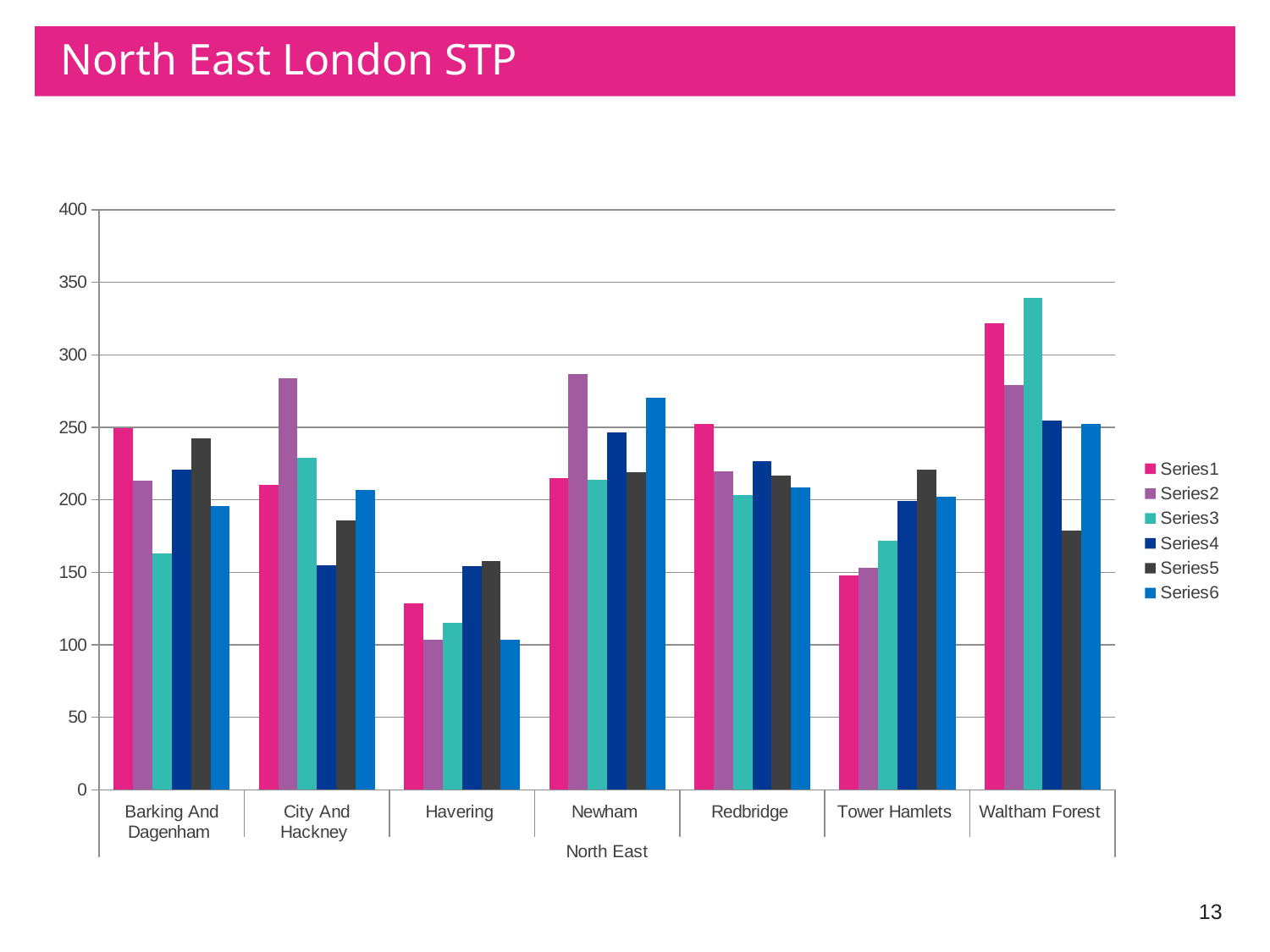
Which borough has the highest value for Series3? Waltham Forest How many boroughs (categories) are shown on the x axis? 7 What label appears beneath the borough names on the x axis? North East What kind of chart is shown on the slide? bar chart Is the Series5 value for Tower Hamlets greater or less than 200? greater Is the Series2 value for City And Hackney greater or less than 250? greater Is the Series3 value for Havering greater or less than 150? less Which is larger: the Series6 value for Newham or the Series6 value for Redbridge? Newham Which is larger: the Series1 value for Waltham Forest or the Series1 value for Redbridge? Waltham Forest Which borough has the lowest value for Series1? Havering What is the title of the slide containing the chart? North East London STP How many series does the legend list? 6